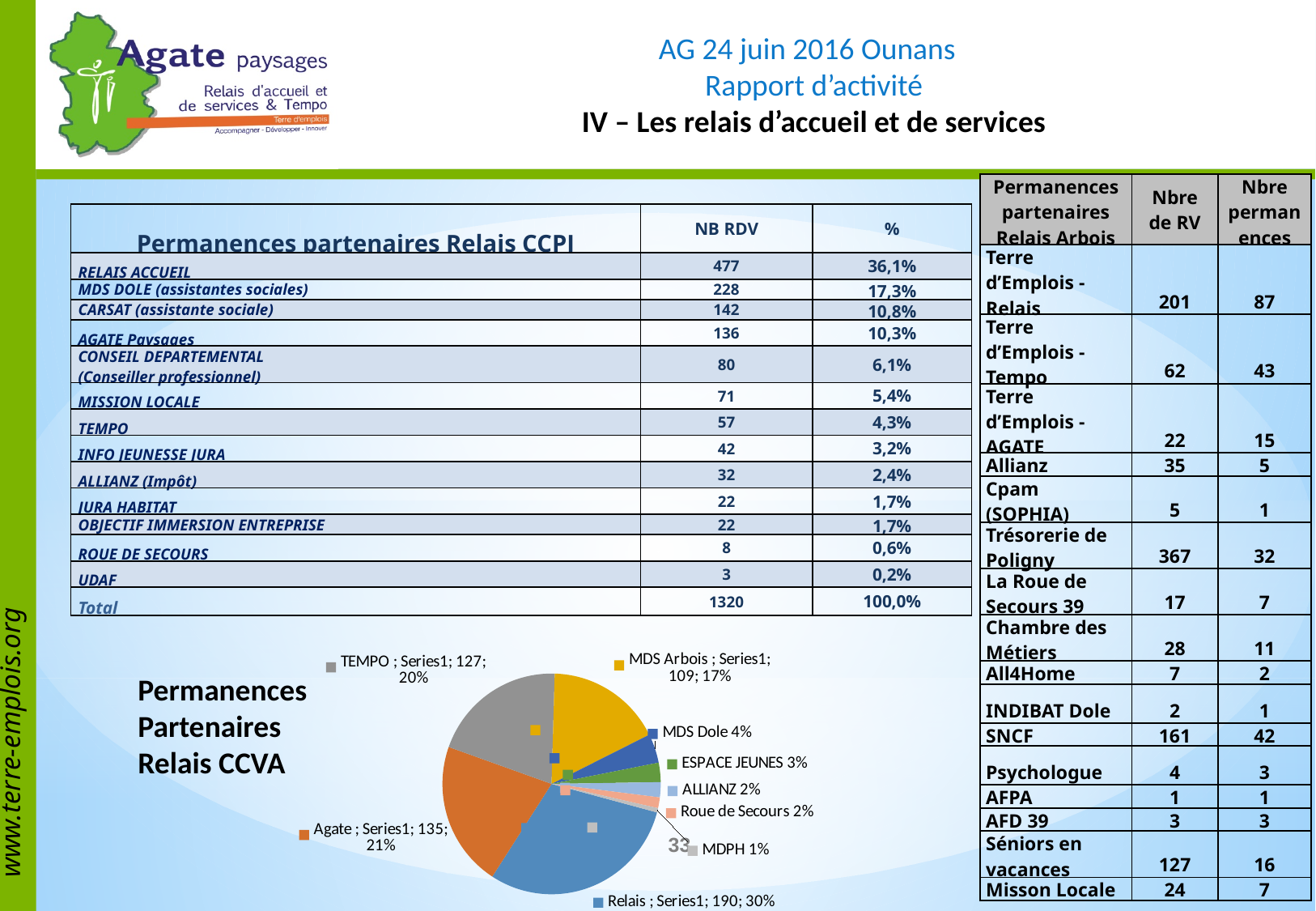
What kind of chart is shown on the slide? pie chart What value is shown for Agate in the pie chart? 135 What value is shown for Relais in the pie chart? 190 What is the title of the pie chart? Permanences Partenaires Relais CCVA What is the difference between the values for Relais and Agate in the pie chart? 55 Which category has the largest slice in the pie chart? Relais What share of the pie does MDS Arbois represent? 17% How many slices does the pie chart have? 9 Which category has the smallest slice in the pie chart? MDPH Which is larger in the pie chart, the slice for TEMPO or the slice for MDS Arbois? TEMPO What share of the pie does MDS Dole represent? 4% What value is shown for TEMPO in the pie chart? 127